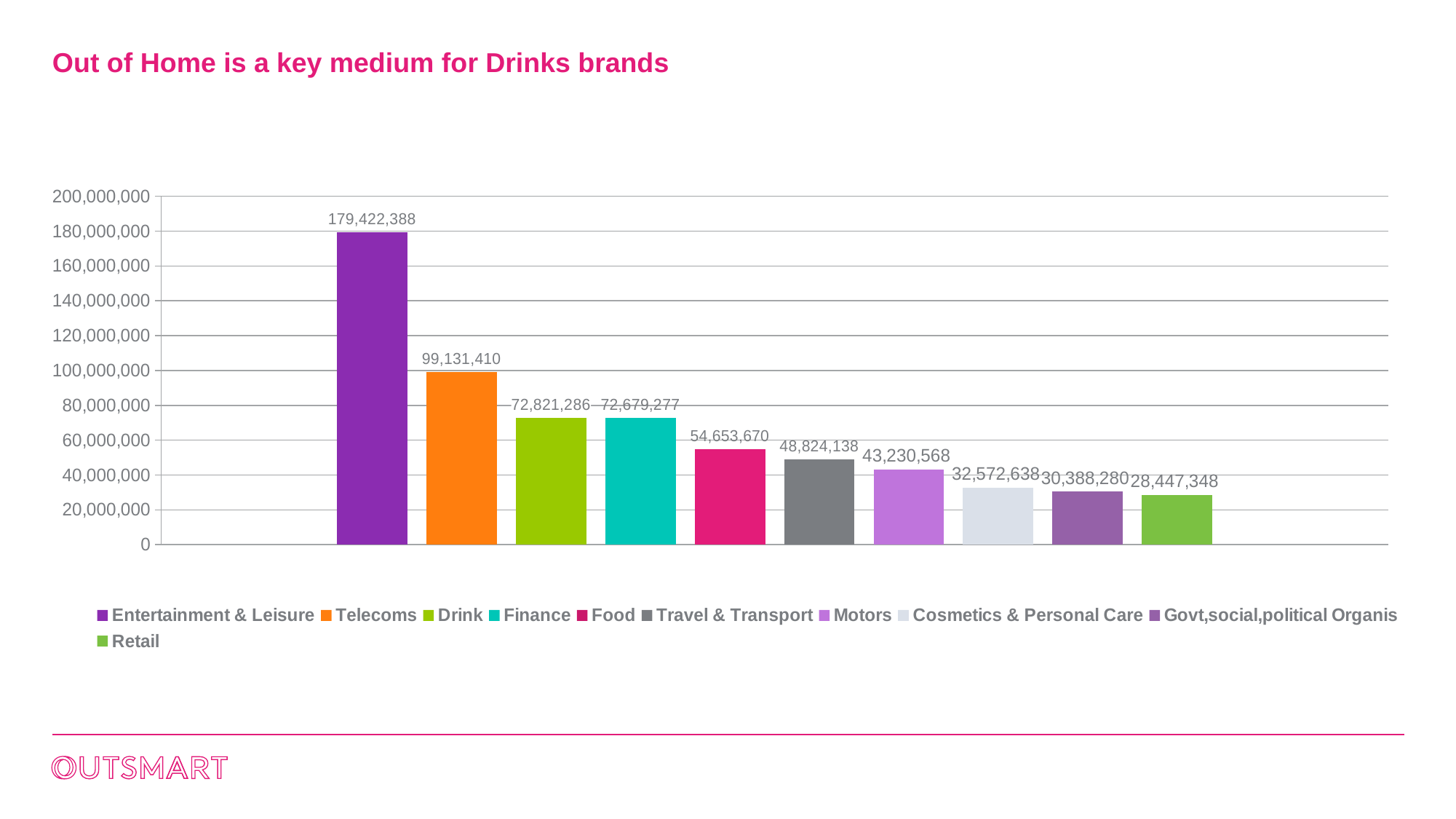
What is the value for Cosmetics & Personal Care? 32,572,638 What is the title of the slide? Out of Home is a key medium for Drinks brands Which is larger, the value for Drink or the value for Finance? Drink What is the difference between the values for Entertainment & Leisure and Telecoms? 80,290,978 How many bars are shown in the chart? 10 What is the difference between the values for Food and Travel & Transport? 5,829,532 Is the value for Motors greater or less than 40,000,000? greater Which category has the lowest value? Retail What is the value for Telecoms? 99,131,410 What is the value for Drink? 72,821,286 What kind of chart is shown on the slide? Bar chart Which category has the highest value? Entertainment & Leisure